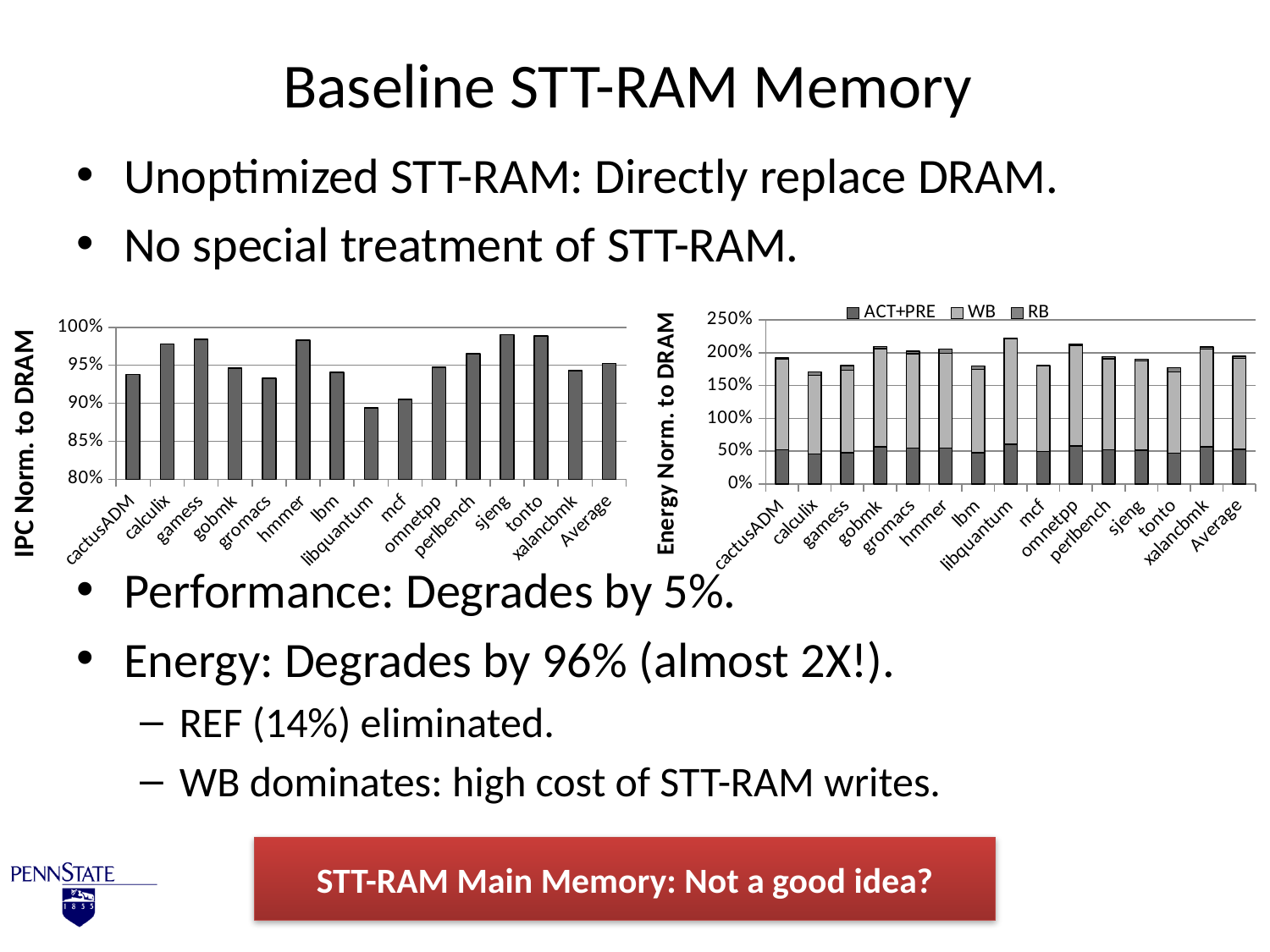
In the left chart (IPC Norm. to DRAM), is the value for libquantum greater or less than 90%? less In the left chart (IPC Norm. to DRAM), is the value for gamess greater or less than 95%? greater How many series does the legend of the right chart (Energy Norm. to DRAM) list? 3 In the right chart (Energy Norm. to DRAM), which category has the highest total bar? libquantum In the left chart (IPC Norm. to DRAM), which is larger, the value for sjeng or the value for libquantum? sjeng What kind of chart is the left chart (IPC Norm. to DRAM)? bar chart In the left chart (IPC Norm. to DRAM), is the value for gromacs greater or less than 95%? less In the left chart (IPC Norm. to DRAM), which category has the lowest value? libquantum What are the legend entries of the right chart (Energy Norm. to DRAM)? ACT+PRE, WB, RB How many categories are shown on the x axis of the left chart (IPC Norm. to DRAM)? 15